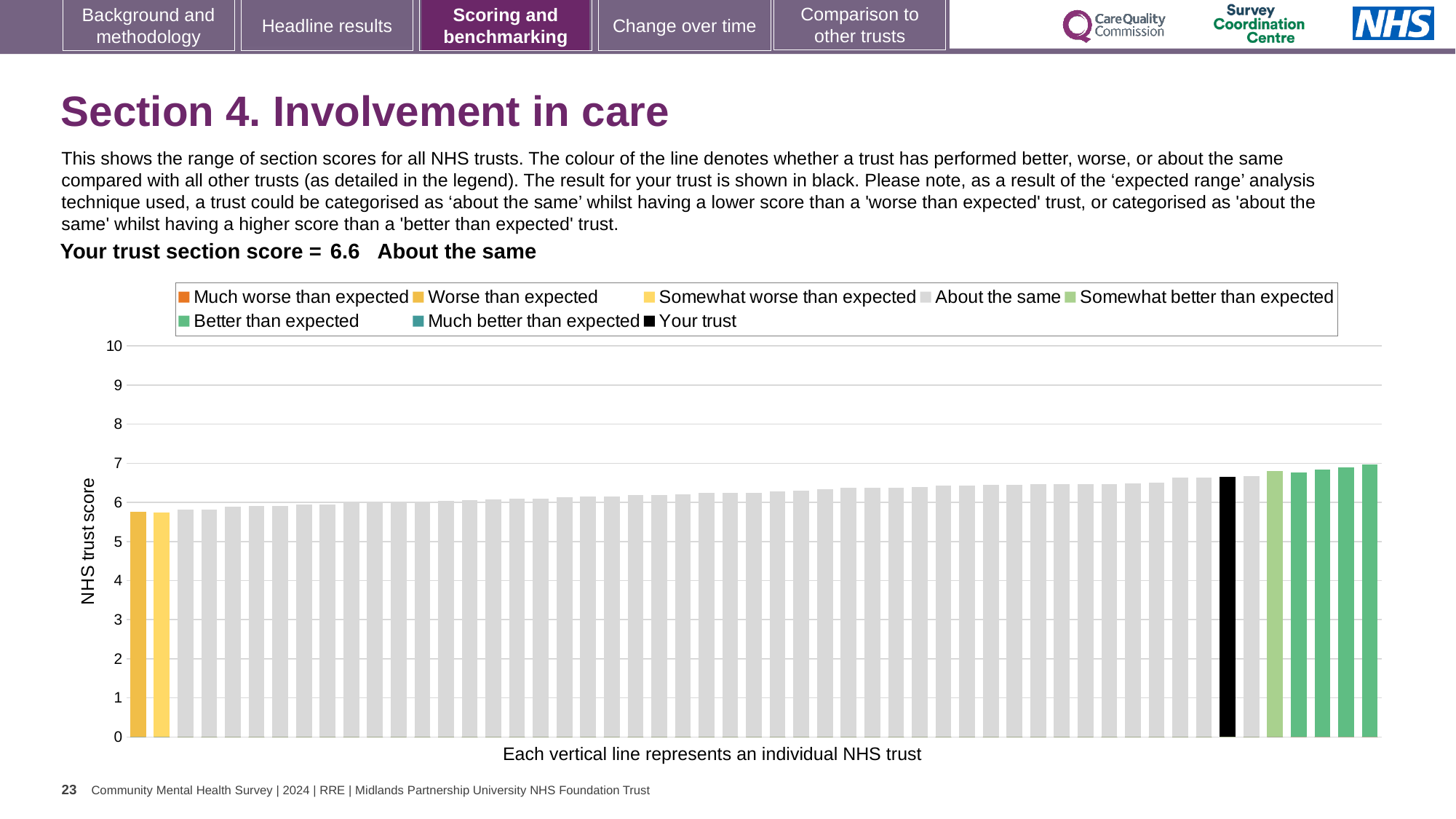
How many entries does the chart legend list? 8 Do the bar values rise or fall from left to right along the x axis? rise What type of chart is shown on the slide? bar chart What is the label on the vertical axis of the chart? NHS trust score Is the value for your trust (the black bar) greater or less than 6? greater Which legend category do the highest bars on the right of the chart belong to? Better than expected What is the section score for your trust shown on the slide? 6.6 Is the value of the highest bar in the chart greater or less than 6? greater How is your trust's section score categorised compared with other trusts? About the same Is the value of the lowest bar in the chart greater or less than 6? less What colour is the bar representing your trust? black How many bars are coloured yellow (Worse than expected)? 1